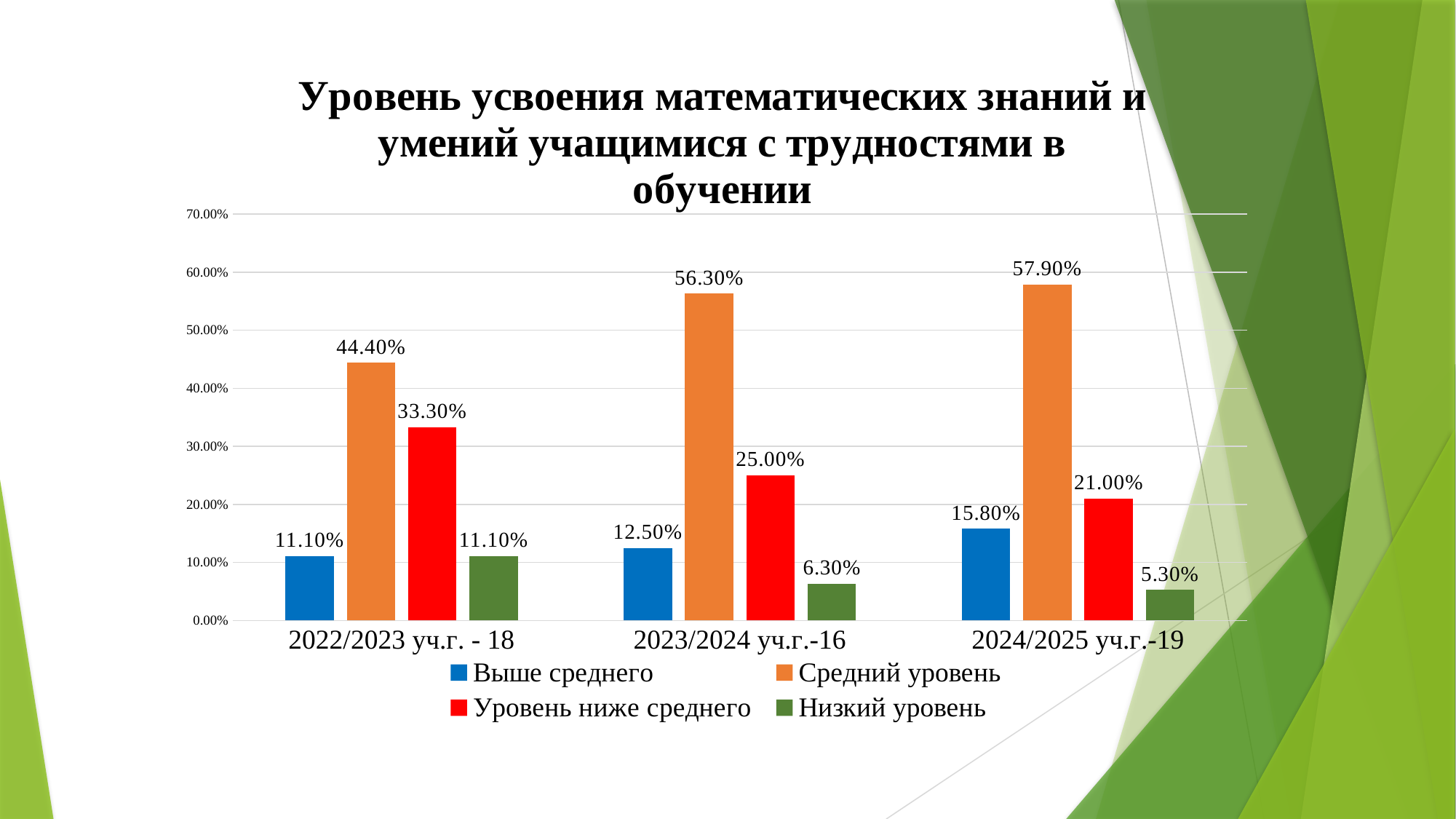
Does the "Уровень ниже среднего" value rise or fall from 2022/2023 to 2024/2025? fall In which school year is the "Средний уровень" value highest? 2024/2025 уч.г.-19 What is the value of "Низкий уровень" for 2024/2025 уч.г.-19? 5.30% Which is larger: "Выше среднего" for 2024/2025 уч.г.-19 or "Выше среднего" for 2022/2023 уч.г. - 18? 2024/2025 уч.г.-19 What is the difference between the "Средний уровень" values for 2023/2024 уч.г.-16 and 2022/2023 уч.г. - 18? 11.90% What kind of chart is shown on the slide? bar chart In which school year is the "Низкий уровень" value lowest? 2024/2025 уч.г.-19 What is the value of "Средний уровень" for 2023/2024 уч.г.-16? 56.30% How many school-year categories are shown on the x axis? 3 What is the value of "Уровень ниже среднего" for 2022/2023 уч.г. - 18? 33.30% Is the value of "Уровень ниже среднего" for 2023/2024 уч.г.-16 greater or less than 30.00%? less How many series does the legend list? 4